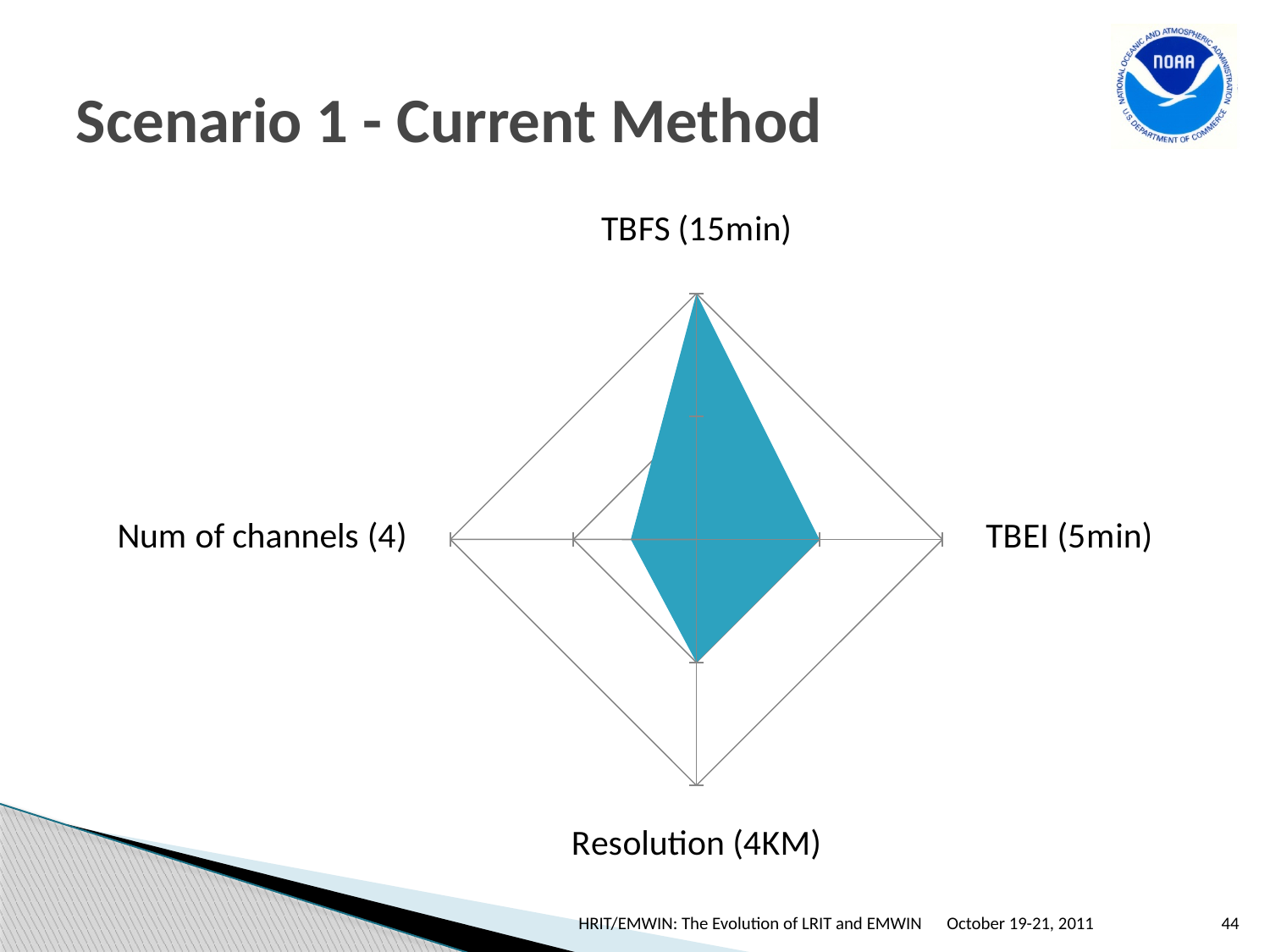
Which category label appears at the bottom of the radar chart? Resolution (4KM) How many axes (categories) does the radar chart have? 4 Which category has the lowest value on the radar chart? Num of channels (4) Which is larger on the radar chart, the value for TBFS (15min) or the value for TBEI (5min)? TBFS (15min) What is the title of the slide containing the radar chart? Scenario 1 - Current Method Which category reaches the highest value on the radar chart? TBFS (15min) What kind of chart is shown on the slide? Radar chart What colour is the filled area of the radar chart? Teal blue Which is larger on the radar chart, the value for Resolution (4KM) or the value for Num of channels (4)? Resolution (4KM) Which is larger on the radar chart, the value for TBEI (5min) or the value for Num of channels (4)? TBEI (5min)